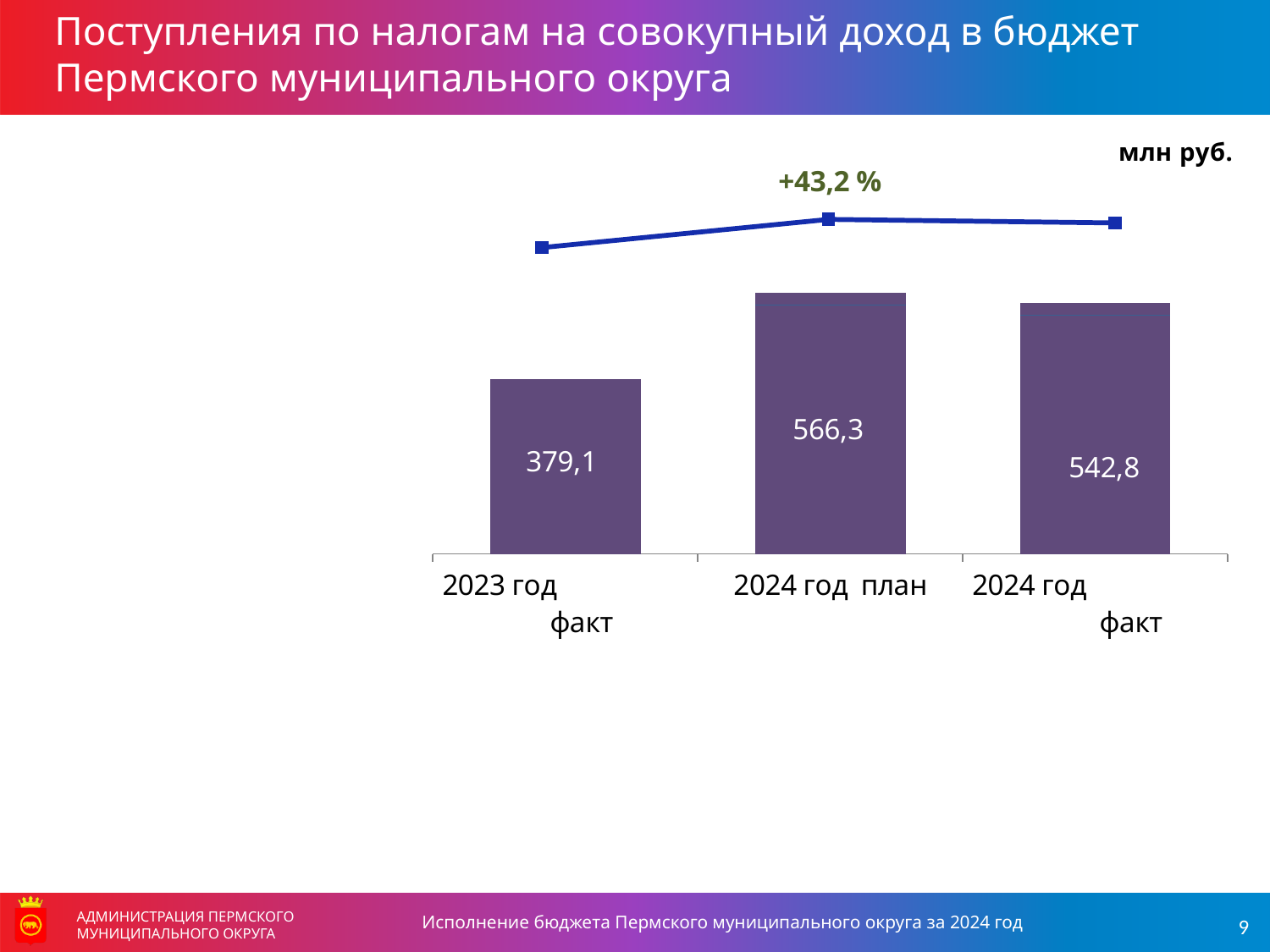
Which category has the lowest value? 2023 год факт Does the value rise or fall from 2023 год факт to 2024 год факт? rise Which category has the highest value? 2024 год план What kind of chart is this? bar chart What is the value for 2024 год план? 566,3 How many categories are shown on the x axis? 3 What is the difference between the 2024 год факт and 2023 год факт values? 163,7 What is the value for 2024 год факт? 542,8 Which is larger, the value for 2024 год план or 2024 год факт? 2024 год план What unit of measurement is indicated for the chart? млн руб. What is the value for 2023 год факт? 379,1 What is the difference between the 2024 год план and 2024 год факт values? 23,5